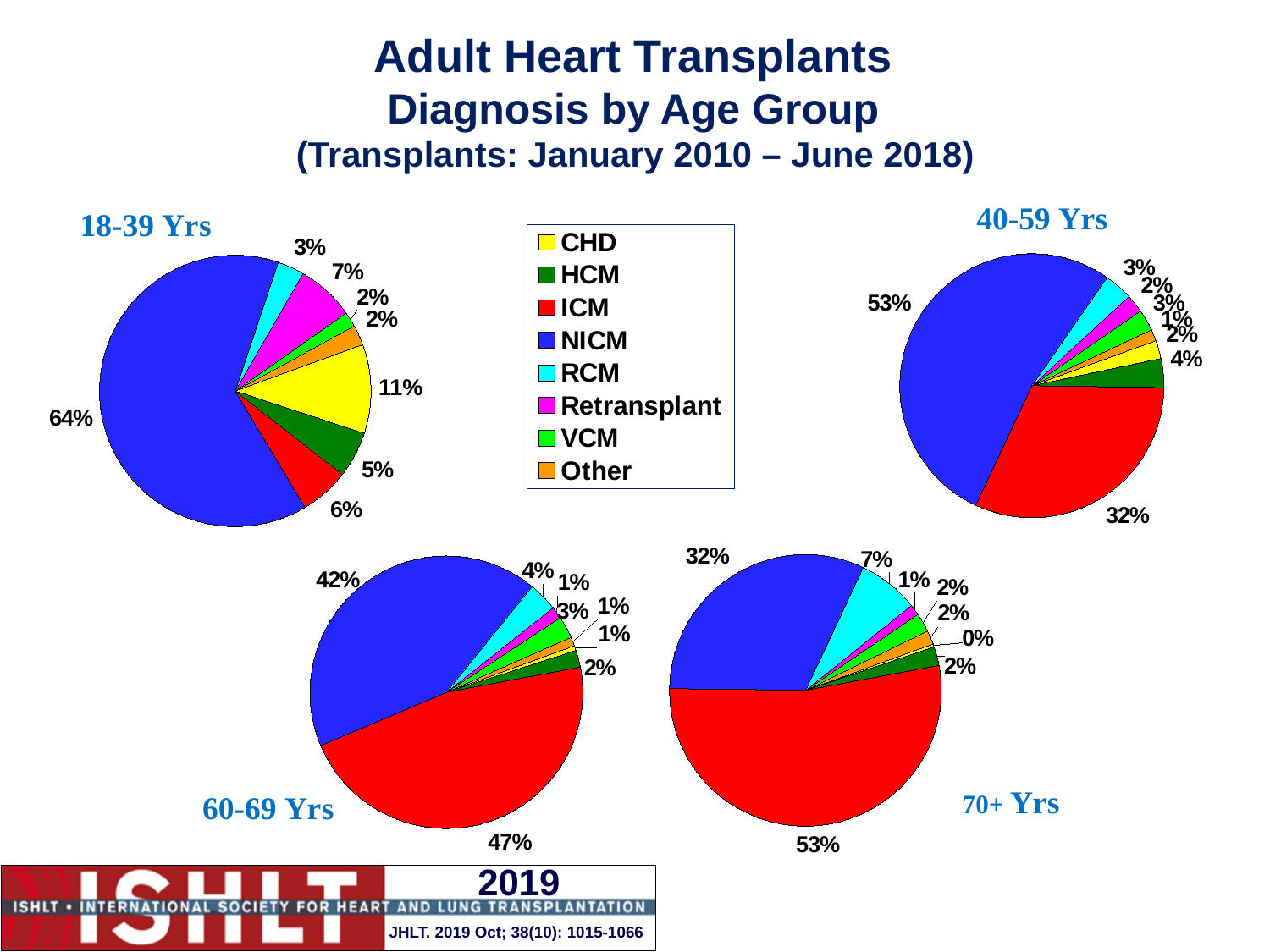
What type of chart is used to show diagnosis by age group on this slide? Pie chart In the 40-59 Yrs pie chart, which diagnosis has the largest share? NICM In the 60-69 Yrs pie chart, what percentage is ICM? 47% How many pie charts are shown on the slide? 4 In the 70+ Yrs pie chart, which diagnosis has the largest share? ICM In the 18-39 Yrs pie chart, which is larger, the Retransplant slice or the HCM slice? Retransplant In the 18-39 Yrs pie chart, what percentage is CHD? 11% In the 60-69 Yrs pie chart, what is the difference between the ICM share and the NICM share? 5% In the 18-39 Yrs pie chart, what percentage is NICM? 64% In the 40-59 Yrs pie chart, what percentage is ICM? 32% How many diagnosis categories does the legend list? 8 In the 70+ Yrs pie chart, what percentage is RCM? 7%